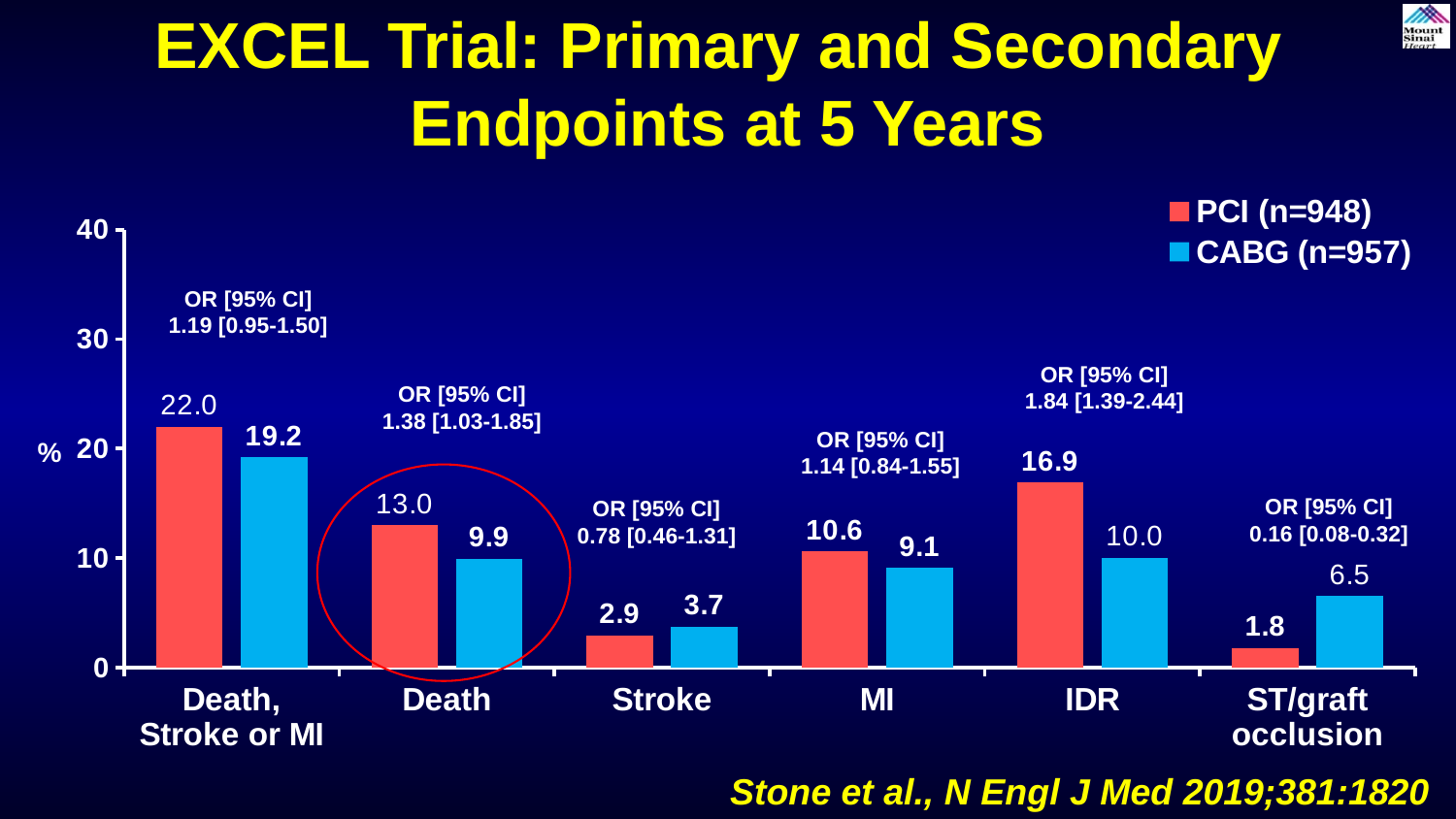
What is the difference between the PCI and CABG values for IDR? 6.9 What is the OR [95% CI] shown for IDR? 1.84 [1.39-2.44] What is the PCI value for Death, Stroke or MI? 22.0 What is the difference between the PCI and CABG values for Death? 3.1 Which category has the highest PCI value? Death, Stroke or MI How many categories are shown on the x axis? 6 Which is larger for Stroke, the PCI value or the CABG value? CABG What is the CABG value for IDR? 10.0 What is the CABG value for ST/graft occlusion? 6.5 What kind of chart is shown on the slide? Bar chart Which category has the lowest PCI value? ST/graft occlusion How many series does the legend list? 2